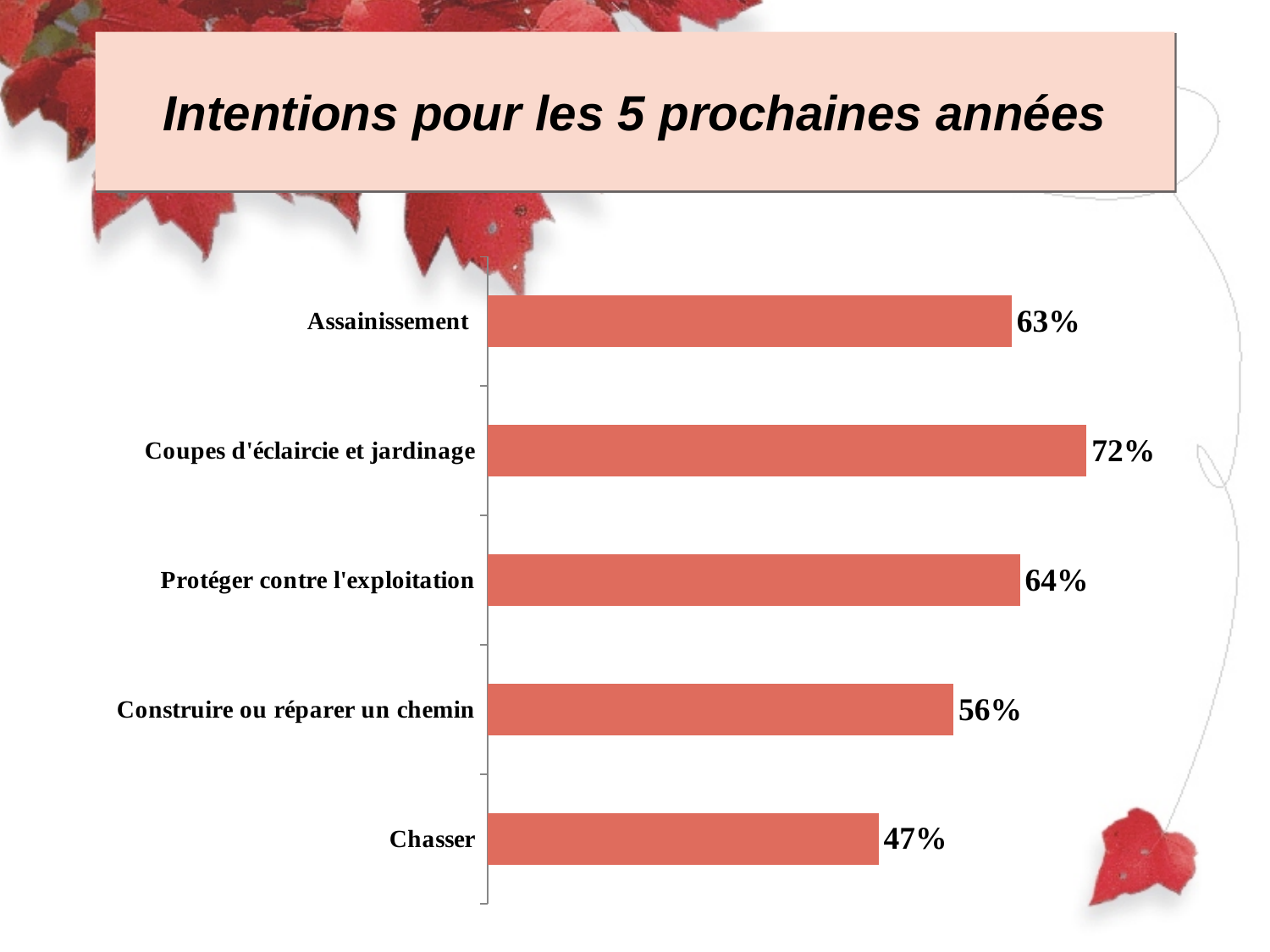
What is the value for Assainissement? 63% Which category has the highest value? Coupes d'éclaircie et jardinage Which is larger, the value for Construire ou réparer un chemin or the value for Chasser? Construire ou réparer un chemin What is the value for Coupes d'éclaircie et jardinage? 72% What is the title of the slide? Intentions pour les 5 prochaines années What is the value for Construire ou réparer un chemin? 56% What kind of chart is shown on the slide? Bar chart Which category has the lowest value? Chasser What is the value for Protéger contre l'exploitation? 64% What is the difference between the values for Coupes d'éclaircie et jardinage and Chasser? 25% How many categories are shown in the chart? 5 What is the value for Chasser? 47%